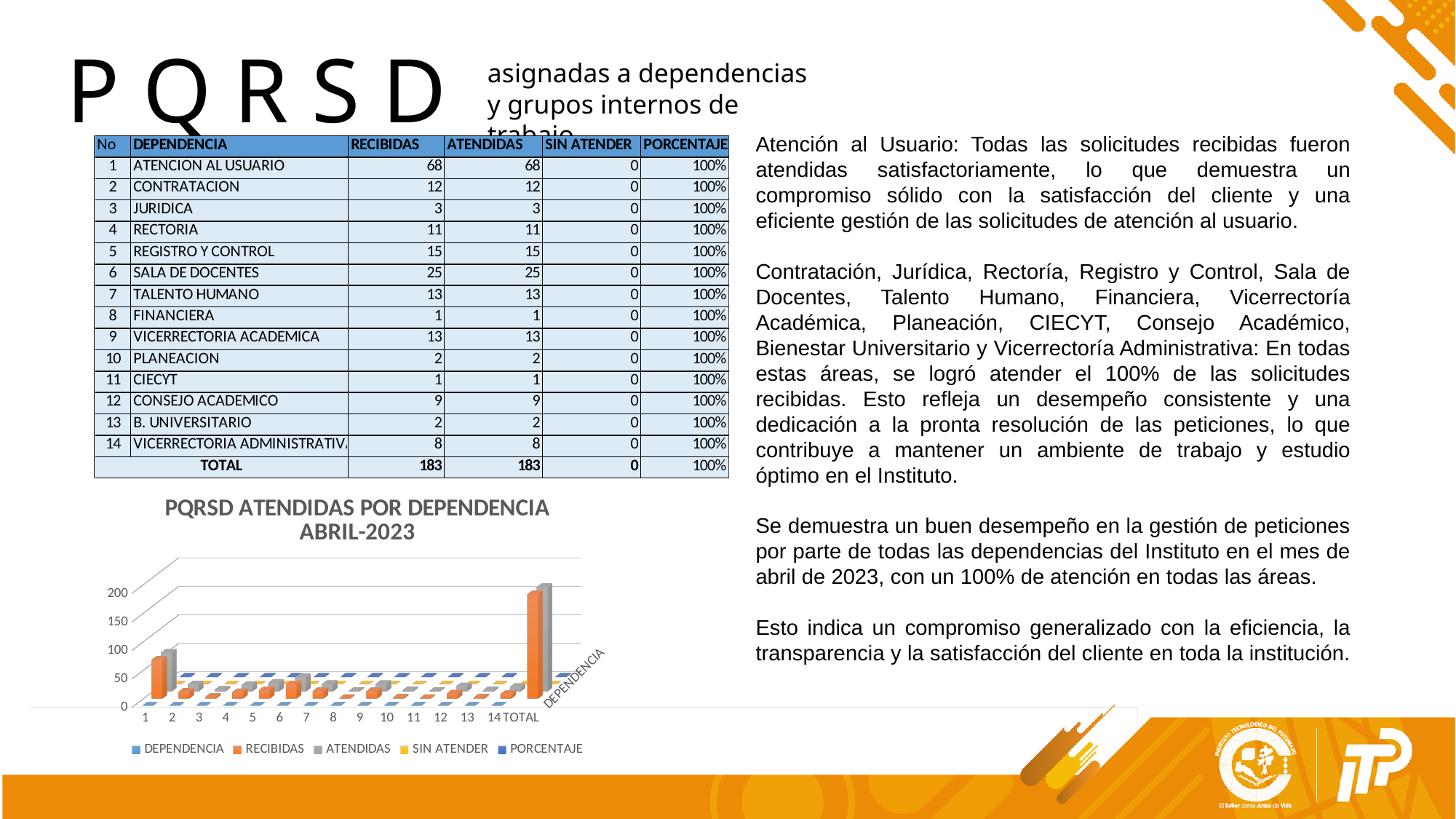
In the chart 'PQRSD ATENDIDAS POR DEPENDENCIA ABRIL-2023', which has the larger RECIBIDAS bar, category 1 or category 2? Category 1 What is the title of the chart on the slide? PQRSD ATENDIDAS POR DEPENDENCIA ABRIL-2023 In the chart 'PQRSD ATENDIDAS POR DEPENDENCIA ABRIL-2023', is the ATENDIDAS value for category 6 greater or less than 50? less In the chart 'PQRSD ATENDIDAS POR DEPENDENCIA ABRIL-2023', which category has the highest RECIBIDAS bar? TOTAL How many categories are shown along the x axis of the chart 'PQRSD ATENDIDAS POR DEPENDENCIA ABRIL-2023'? 15 How many series does the legend of the chart 'PQRSD ATENDIDAS POR DEPENDENCIA ABRIL-2023' list? 5 According to the slide, what is the TOTAL value of RECIBIDAS plotted in the chart 'PQRSD ATENDIDAS POR DEPENDENCIA ABRIL-2023'? 183 According to the slide, what is the ATENDIDAS value for category 6 (SALA DE DOCENTES) plotted in the chart? 25 What kind of chart is shown under the title 'PQRSD ATENDIDAS POR DEPENDENCIA ABRIL-2023'? Bar chart In the chart 'PQRSD ATENDIDAS POR DEPENDENCIA ABRIL-2023', is the RECIBIDAS value for category 1 greater or less than 100? less In the chart 'PQRSD ATENDIDAS POR DEPENDENCIA ABRIL-2023', what colour represents the RECIBIDAS series? Orange In the chart 'PQRSD ATENDIDAS POR DEPENDENCIA ABRIL-2023', is the RECIBIDAS value for TOTAL greater or less than 150? greater